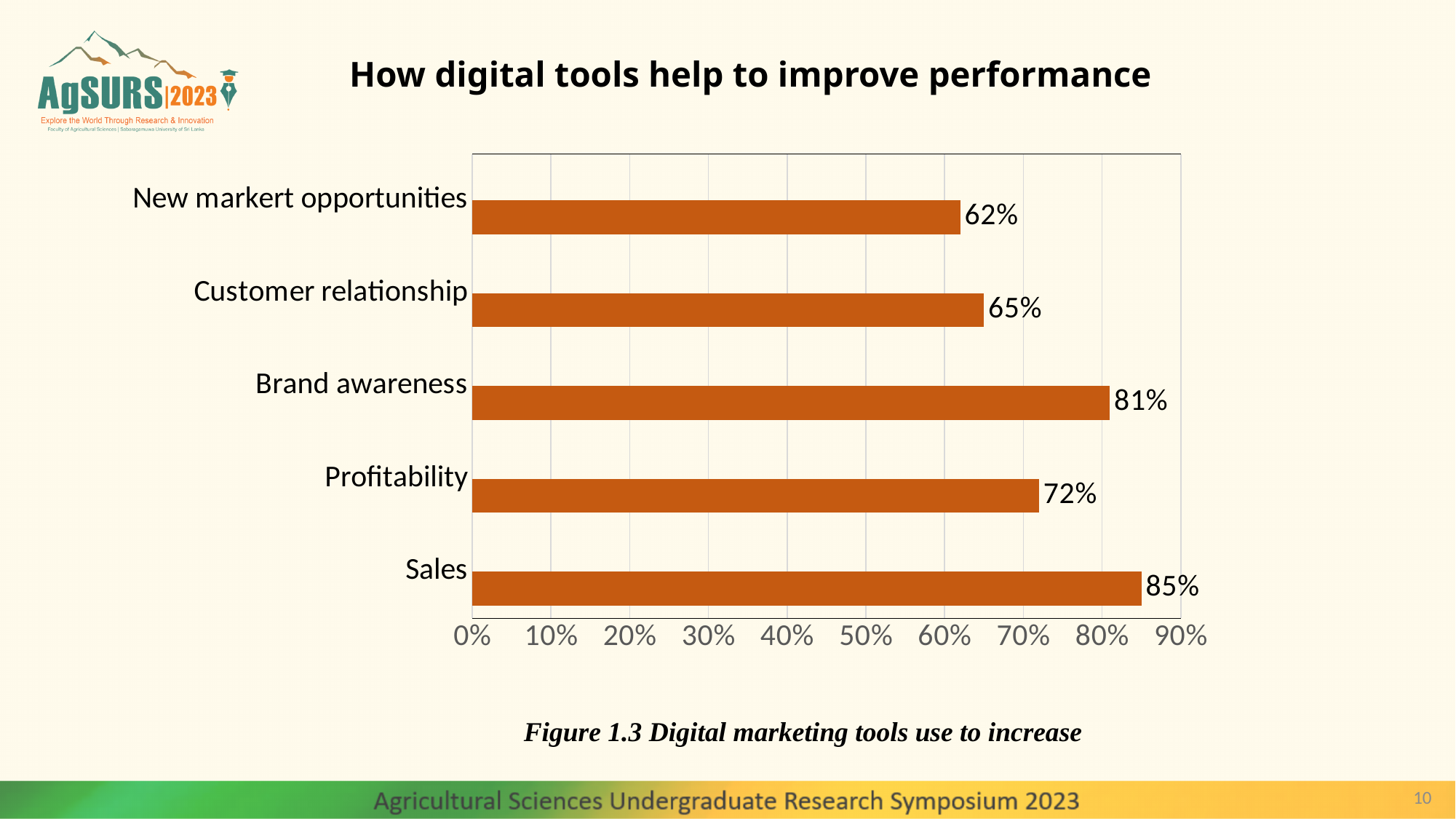
What is the figure caption below the chart? Figure 1.3 Digital marketing tools use to increase What is the value for New markert opportunities? 62% What is the value for Brand awareness? 81% How many categories are shown in the chart? 5 Which category has the lowest value? New markert opportunities Which is larger, the value for Brand awareness or the value for Customer relationship? Brand awareness What kind of chart is shown on the slide? bar chart Which category has the highest value? Sales Is the value for Profitability greater or less than 70%? greater What is the value for Customer relationship? 65% What is the difference between the values for Sales and Profitability? 13% What is the value for Sales? 85%